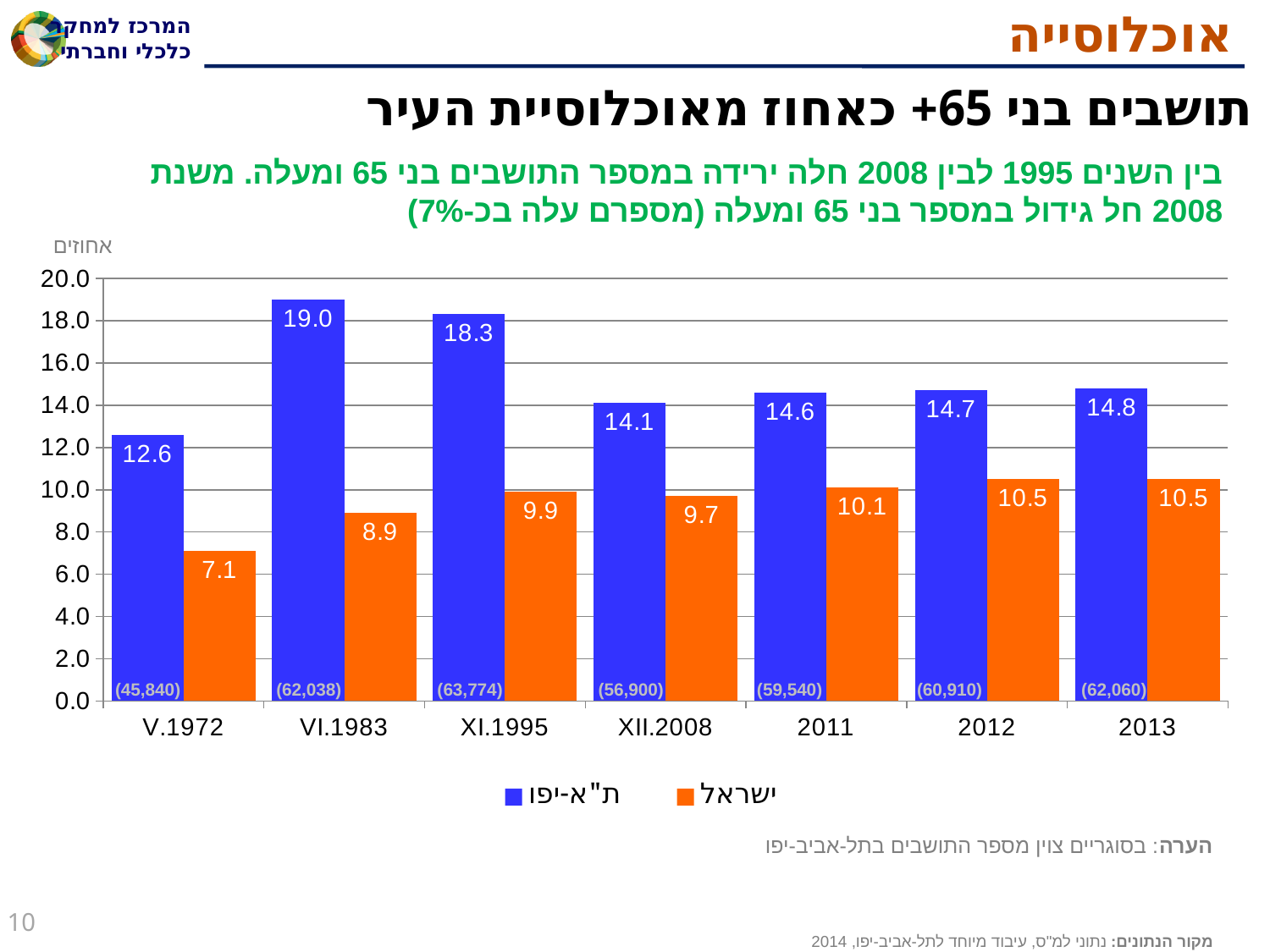
How many series does the legend list? 2 In which category is the ת"א-יפו value highest? VI.1983 How many categories are shown on the x axis? 7 Which is larger in 2011: the ת"א-יפו value or the ישראל value? ת"א-יפו What is the value for ת"א-יפו in VI.1983? 19.0 What is the difference between the ת"א-יפו and ישראל values in V.1972? 5.5 What kind of chart is shown on the slide? bar chart What number is shown in parentheses at the base of the ת"א-יפו bar for XII.2008? (56,900) In which category is the ישראל value lowest? V.1972 What is the value for ת"א-יפו in 2013? 14.8 What is the value for ישראל in XI.1995? 9.9 Which colour represents the ישראל series? orange